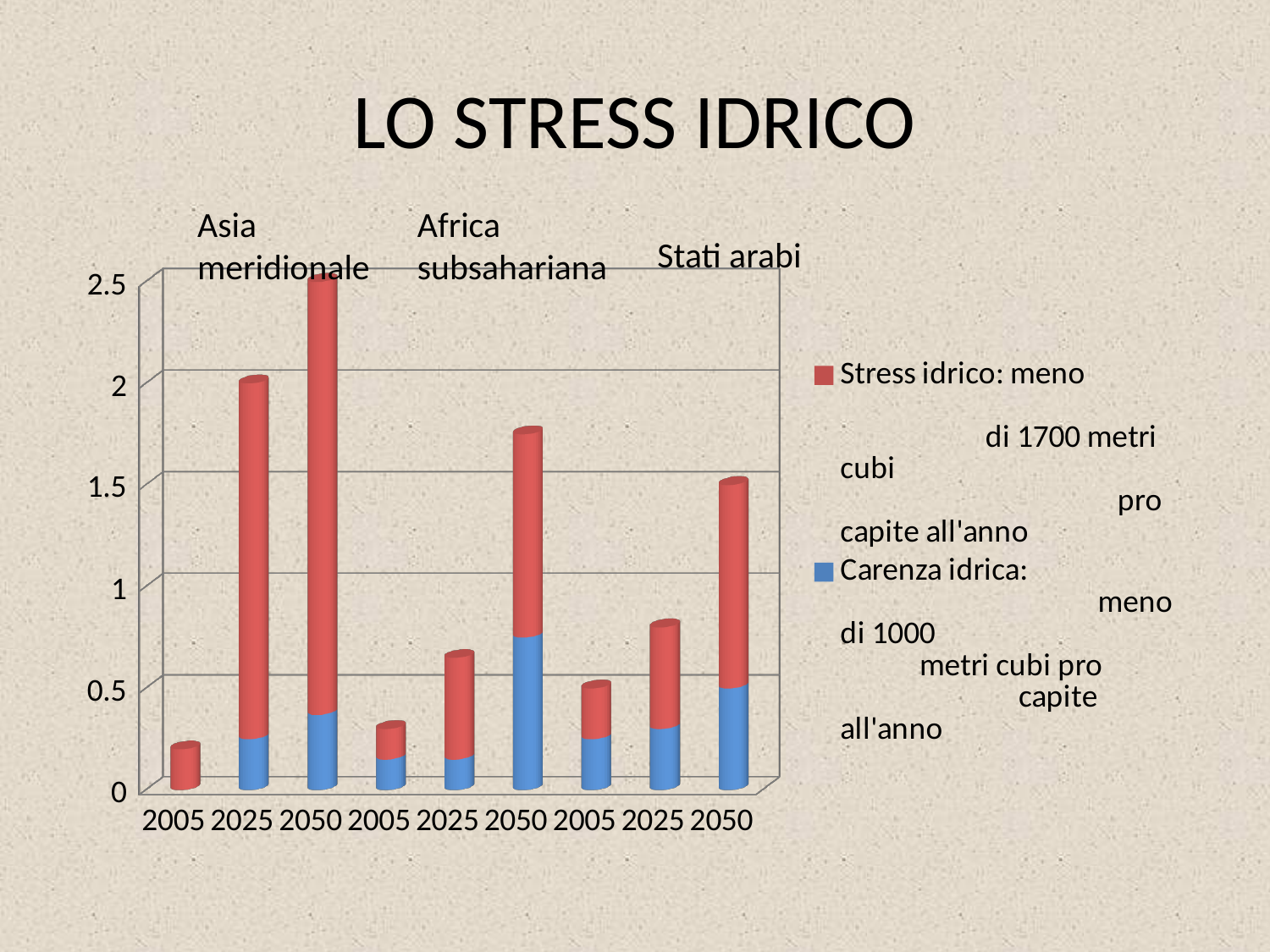
What is the title of the slide containing the chart? LO STRESS IDRICO How many series does the legend list? 2 Within each region, do the bars rise or fall from 2005 to 2050? rise How many bars are plotted in the chart? 9 What kind of chart is shown on the slide? bar chart Is the total value for Stati arabi in 2025 greater or less than 1? less What colour represents the series 'Carenza idrica' in the legend? blue Which bar is the shortest in the chart? Asia meridionale 2005 Which is larger: the total bar for Asia meridionale in 2025 or the total bar for Stati arabi in 2050? Asia meridionale 2025 Which bar is the tallest in the chart? Asia meridionale 2050 Is the total value for Africa subsahariana in 2050 greater or less than 1.5? greater Is the total value for Africa subsahariana in 2025 greater or less than 1? less